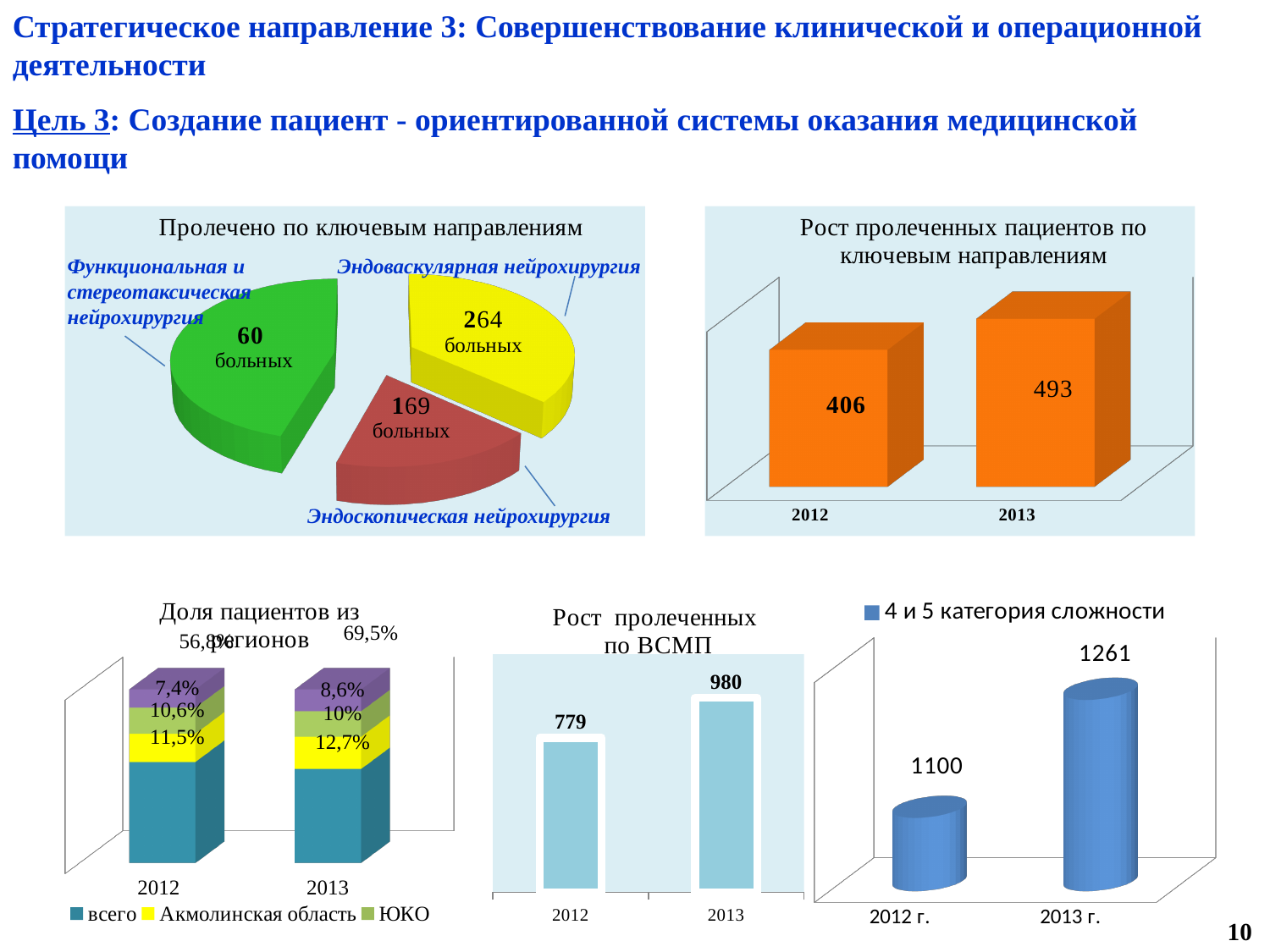
In the chart 'Доля пациентов из регионов', what is the value of the Акмолинская область segment for 2013? 12,7% What kind of chart is 'Пролечено по ключевым направлениям'? Pie chart In the chart '4 и 5 категория сложности', what is the difference between 2013 г. and 2012 г.? 161 In the chart 'Рост пролеченных по ВСМП', which year has the higher value? 2013 In the chart 'Рост пролеченных пациентов по ключевым направлениям', what is the value for 2013? 493 In the chart 'Пролечено по ключевым направлениям', how many patients were treated in Эндоваскулярная нейрохирургия? 264 больных In the chart 'Пролечено по ключевым направлениям', which direction has the fewest patients? Функциональная и стереотаксическая нейрохирургия In the chart 'Рост пролеченных по ВСМП', what is the value for 2012? 779 How many bars are shown in the chart 'Рост пролеченных по ВСМП'? 2 In the chart '4 и 5 категория сложности', what is the value for 2013 г.? 1261 In the chart 'Пролечено по ключевым направлениям', what is the difference between Эндоваскулярная нейрохирургия and Эндоскопическая нейрохирургия? 95 In the chart 'Рост пролеченных пациентов по ключевым направлениям', by how much did the value increase from 2012 to 2013? 87